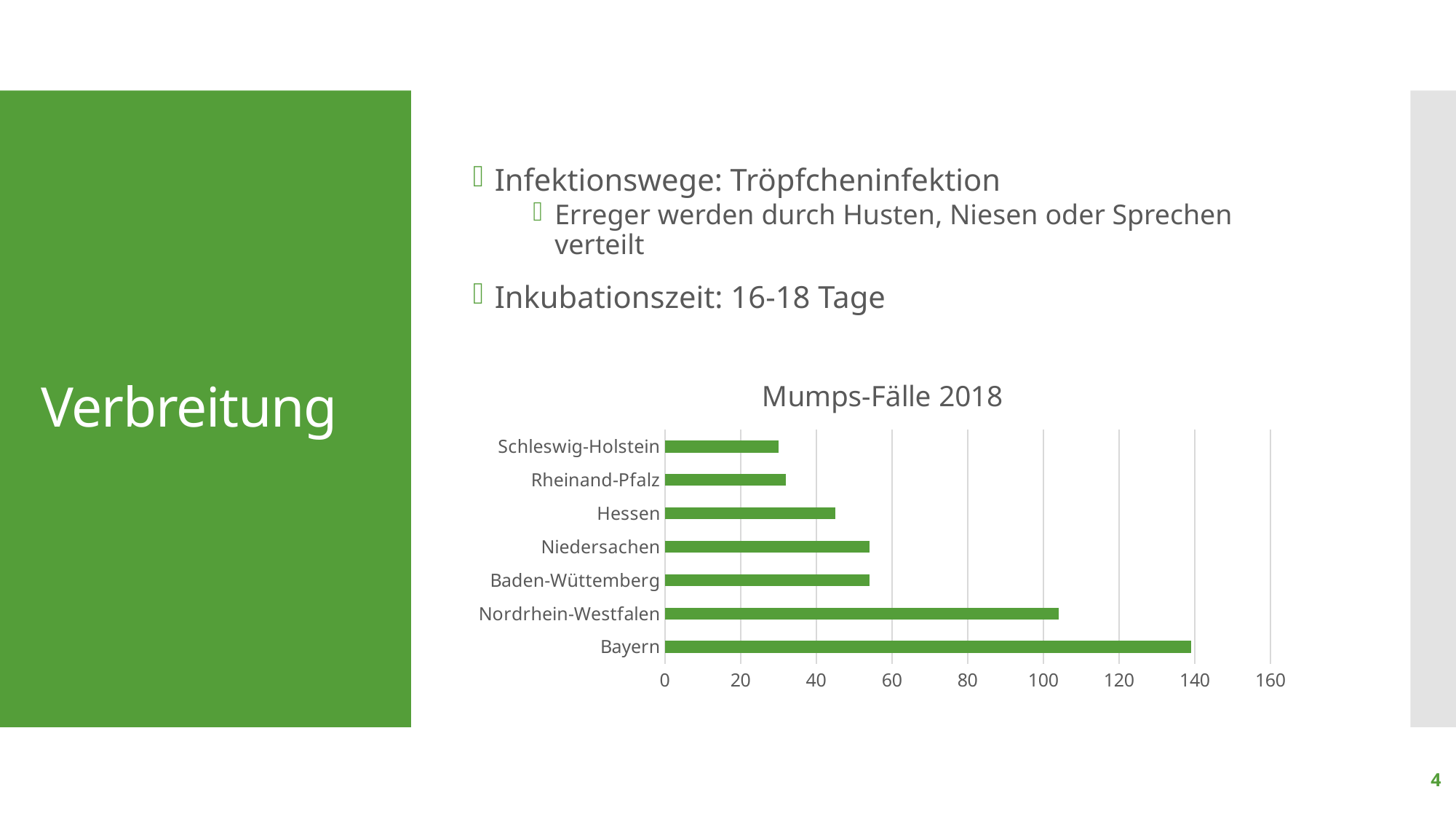
Which has more mumps cases, Nordrhein-Westfalen or Hessen? Nordrhein-Westfalen What type of chart is shown on the slide? bar chart Is the value for Hessen greater or less than 60? less Is the value for Nordrhein-Westfalen greater or less than 80? greater Which has more mumps cases, Bayern or Nordrhein-Westfalen? Bayern Which federal state has the highest number of mumps cases in the chart? Bayern Is the value for Niedersachsen greater or less than 60? less What is the title of the chart? Mumps-Fälle 2018 What is the highest value shown on the x axis of the chart? 160 How many federal states (categories) are shown in the chart? 7